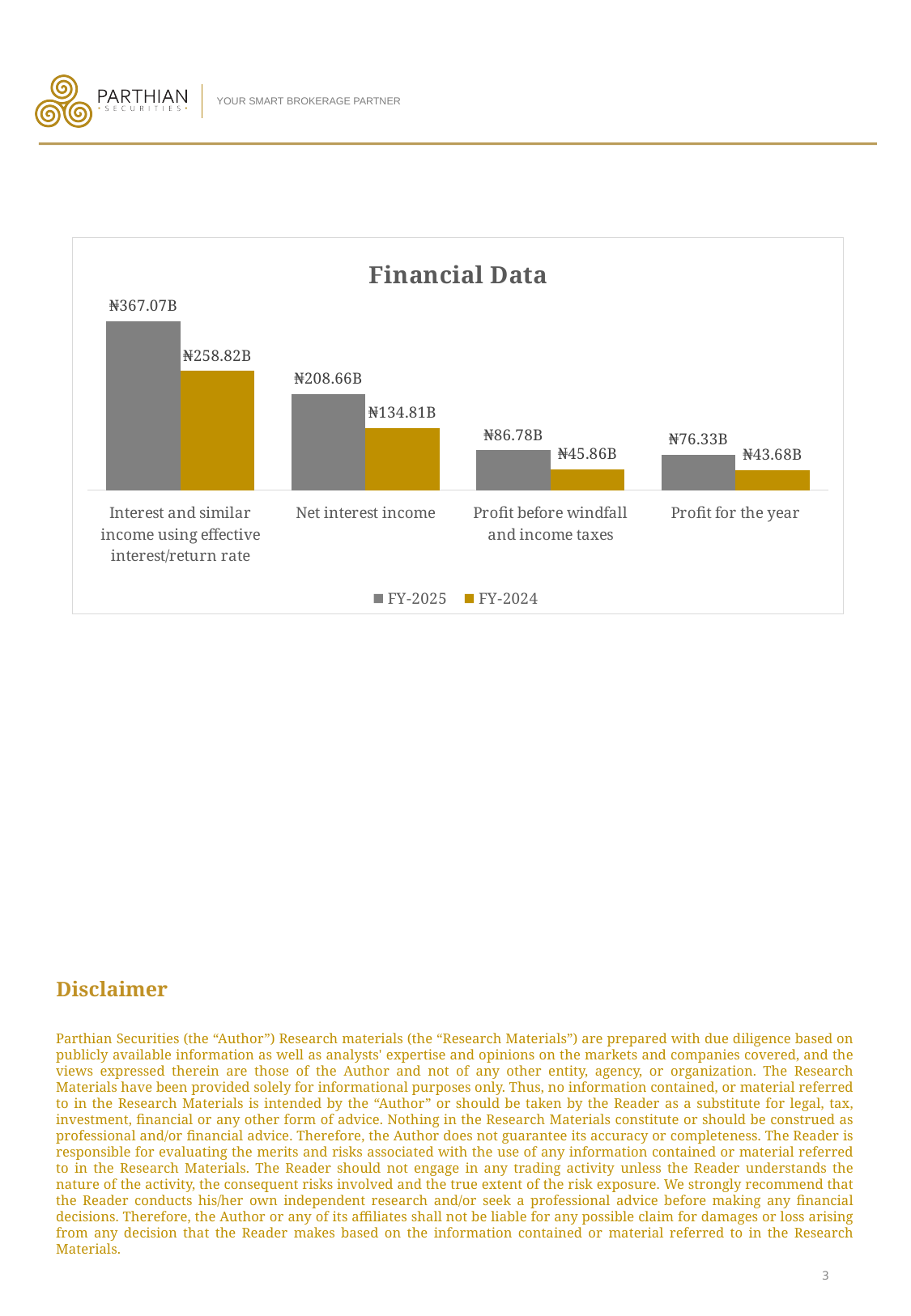
What is the FY-2024 value for Profit for the year? ₦43.68B What is the FY-2025 value for Net interest income? ₦208.66B What kind of chart is shown? Bar chart What is the difference between the FY-2025 and FY-2024 values for Net interest income? ₦73.85B What is the FY-2025 value for Profit before windfall and income taxes? ₦86.78B Which category has the lowest FY-2024 value? Profit for the year What is the title of the chart? Financial Data Which is larger: the FY-2025 value for Profit for the year or the FY-2024 value for Profit before windfall and income taxes? FY-2025 Profit for the year Which category has the highest FY-2025 value? Interest and similar income using effective interest/return rate What is the FY-2024 value for Interest and similar income using effective interest/return rate? ₦258.82B How many categories are shown on the x axis? 4 How many series does the legend list? 2